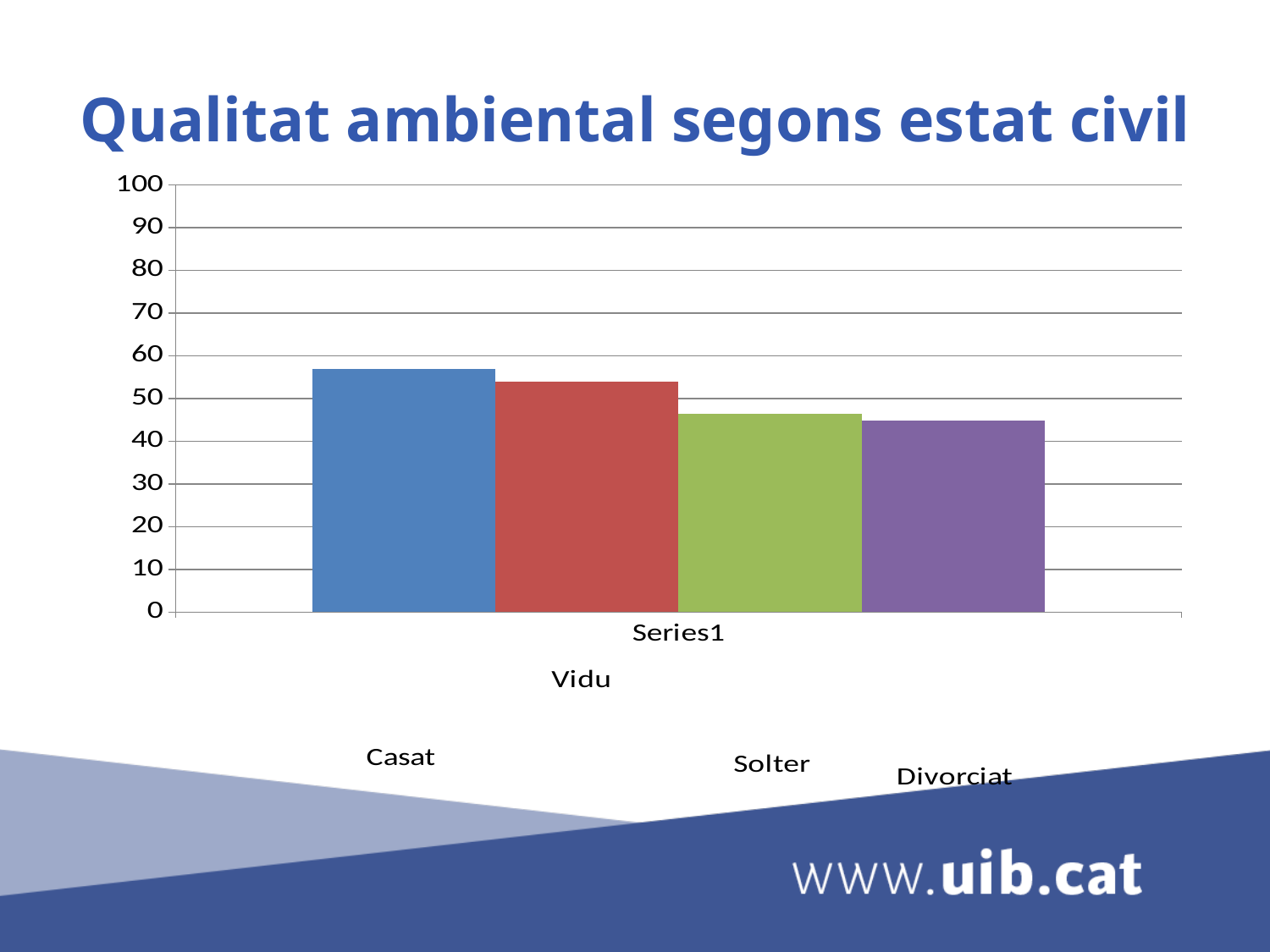
Do the bar values rise or fall from left to right across the chart? fall Is the value for Casat greater or less than 50? greater What is the title of the chart on the slide? Qualitat ambiental segons estat civil Is the value for Vidu greater or less than 50? greater Is the value for Solter greater or less than 50? less How many bars are plotted in the chart? 4 Which is larger, the value for Casat or the value for Solter? Casat What kind of chart is shown on the slide? bar chart Which category has the highest bar in the chart? Casat Which is larger, the value for Vidu or the value for Divorciat? Vidu